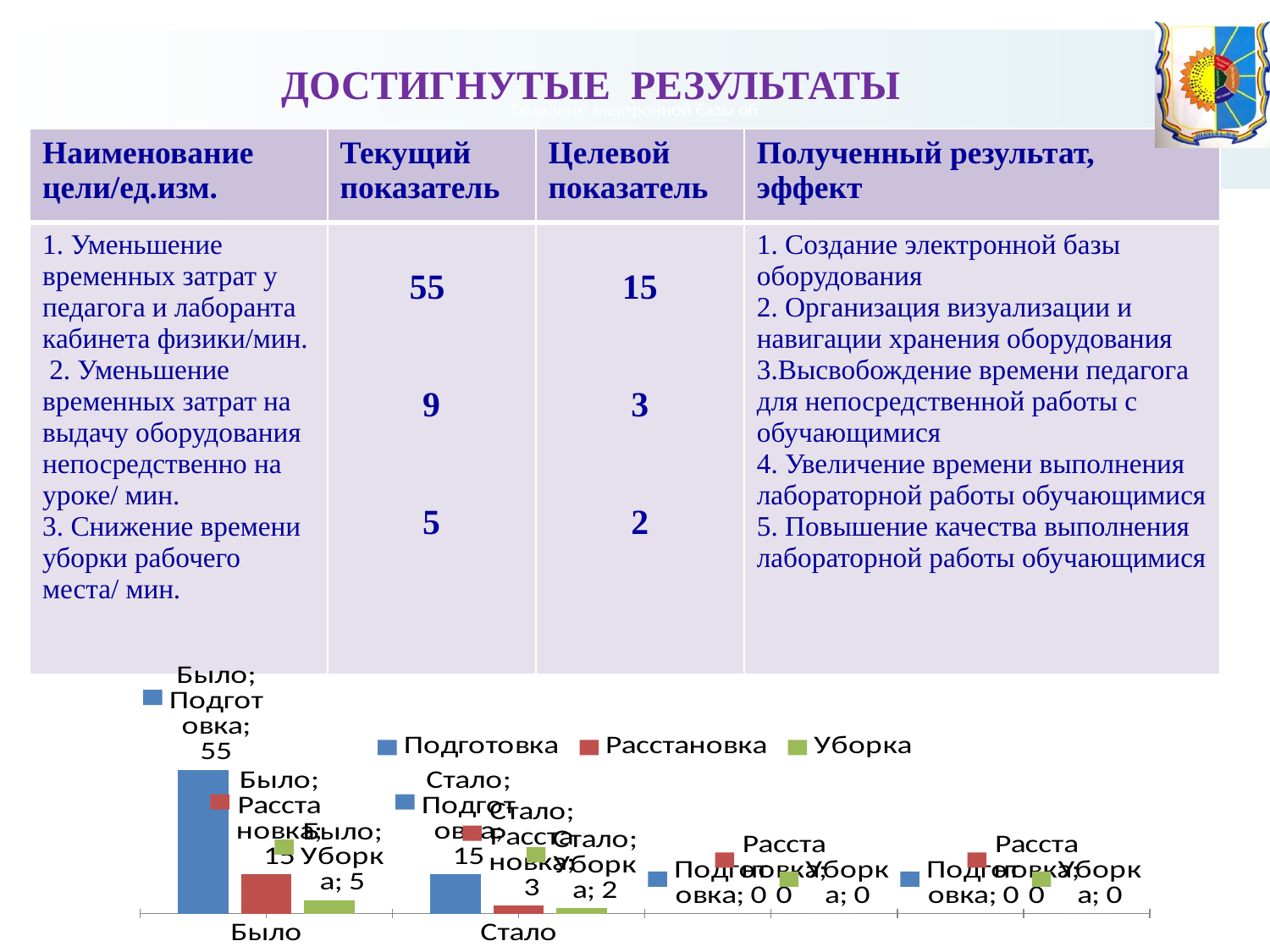
What is the value of Уборка for the Стало category? 2 What is the value of Расстановка for the Стало category? 3 How many series does the chart legend list? 3 What is the value of Уборка for the Было category? 5 Which series has the highest value in the Было category? Подготовка Is the Подготовка value larger for Было or for Стало? Было What colour represents the Подготовка series in the chart? blue What is the value of Подготовка for the Было category? 55 What is the value of Подготовка for the Стало category? 15 What kind of chart is shown at the bottom of the slide? bar chart Which series are listed in the chart legend? Подготовка, Расстановка, Уборка What is the difference between the Подготовка values for Было and Стало? 40